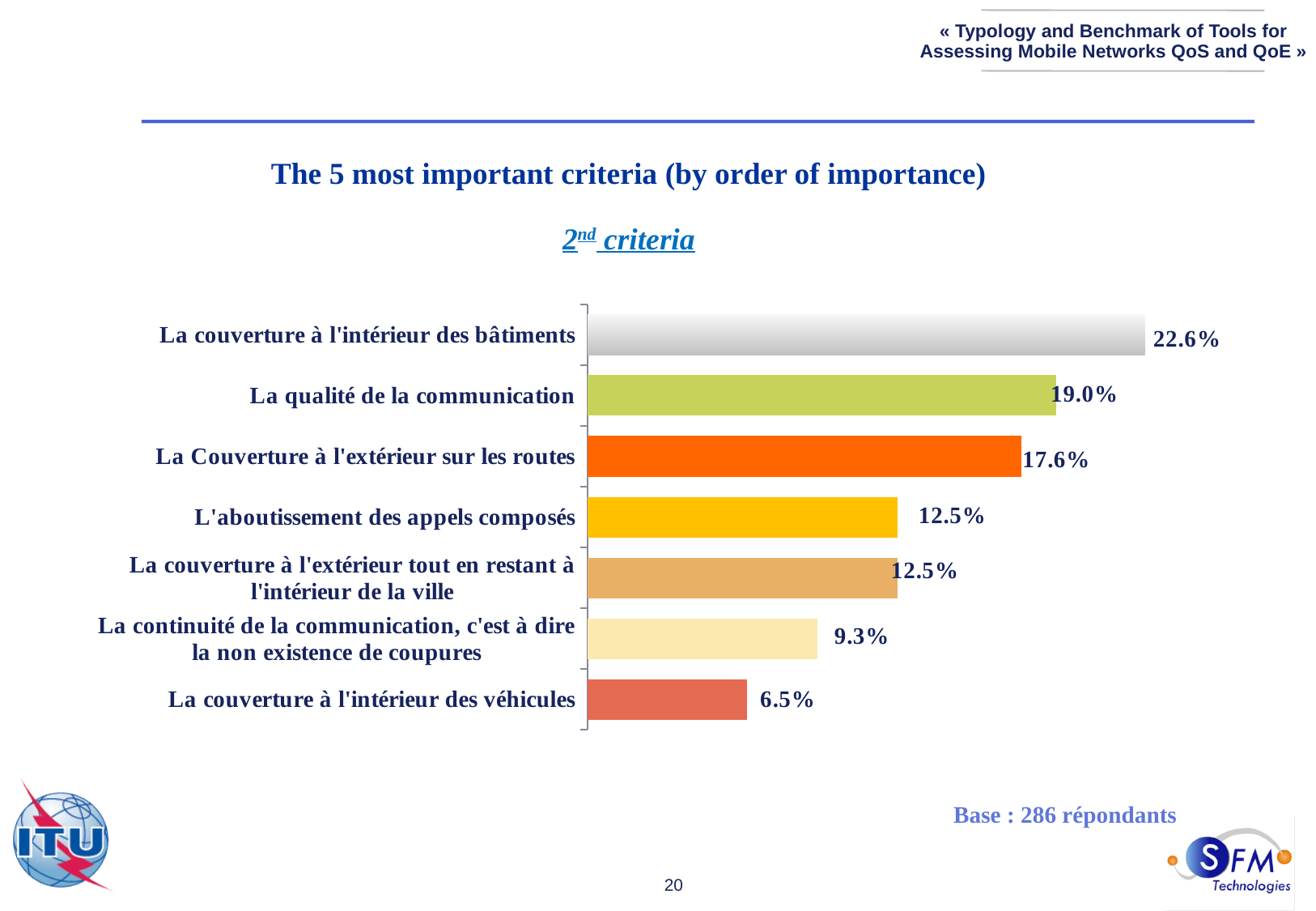
Which category has the highest value? La couverture à l'intérieur des bâtiments What kind of chart is shown on the slide? Bar chart What is the difference between the values for "La continuité de la communication, c'est à dire la non existence de coupures" and "La couverture à l'intérieur des véhicules"? 2.8% What is the value for "La continuité de la communication, c'est à dire la non existence de coupures"? 9.3% Which is larger: the value for "La Couverture à l'extérieur sur les routes" or for "L'aboutissement des appels composés"? La Couverture à l'extérieur sur les routes What is the value for "La qualité de la communication"? 19.0% How many categories are shown in the chart? 7 What is the difference between the values for "La couverture à l'intérieur des bâtiments" and "La qualité de la communication"? 3.6% What is the base (number of respondents) stated on the slide? 286 répondants What is the value for "La couverture à l'intérieur des bâtiments"? 22.6% Which category has the lowest value? La couverture à l'intérieur des véhicules What is the value for "La couverture à l'intérieur des véhicules"? 6.5%